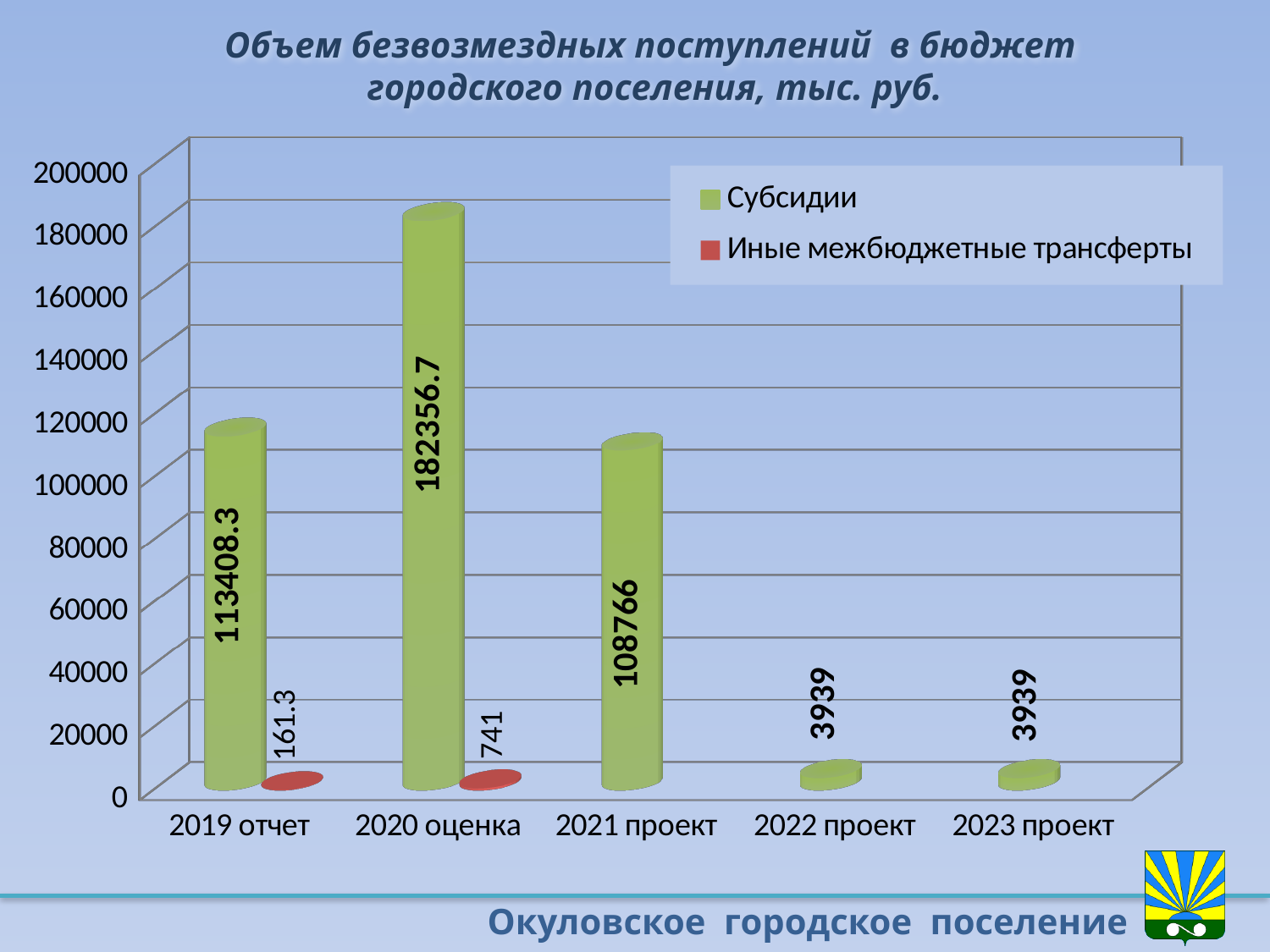
What is the difference between the Субсидии values for 2020 оценка and 2021 проект? 73590.7 Is the value of Субсидии for 2021 проект greater or less than 100000? greater How many year categories are shown on the x axis? 5 What kind of chart is shown on the slide? bar chart Which is larger: Субсидии for 2019 отчет or Субсидии for 2021 проект? 2019 отчет How many series does the legend list? 2 What is the value of Иные межбюджетные трансферты for 2019 отчет? 161.3 What is the value of Субсидии for 2020 оценка? 182356.7 In which year is the value of Субсидии the highest? 2020 оценка Which colour represents Иные межбюджетные трансферты in the legend? red What is the value of Субсидии for 2019 отчет? 113408.3 What is the value of Иные межбюджетные трансферты for 2020 оценка? 741